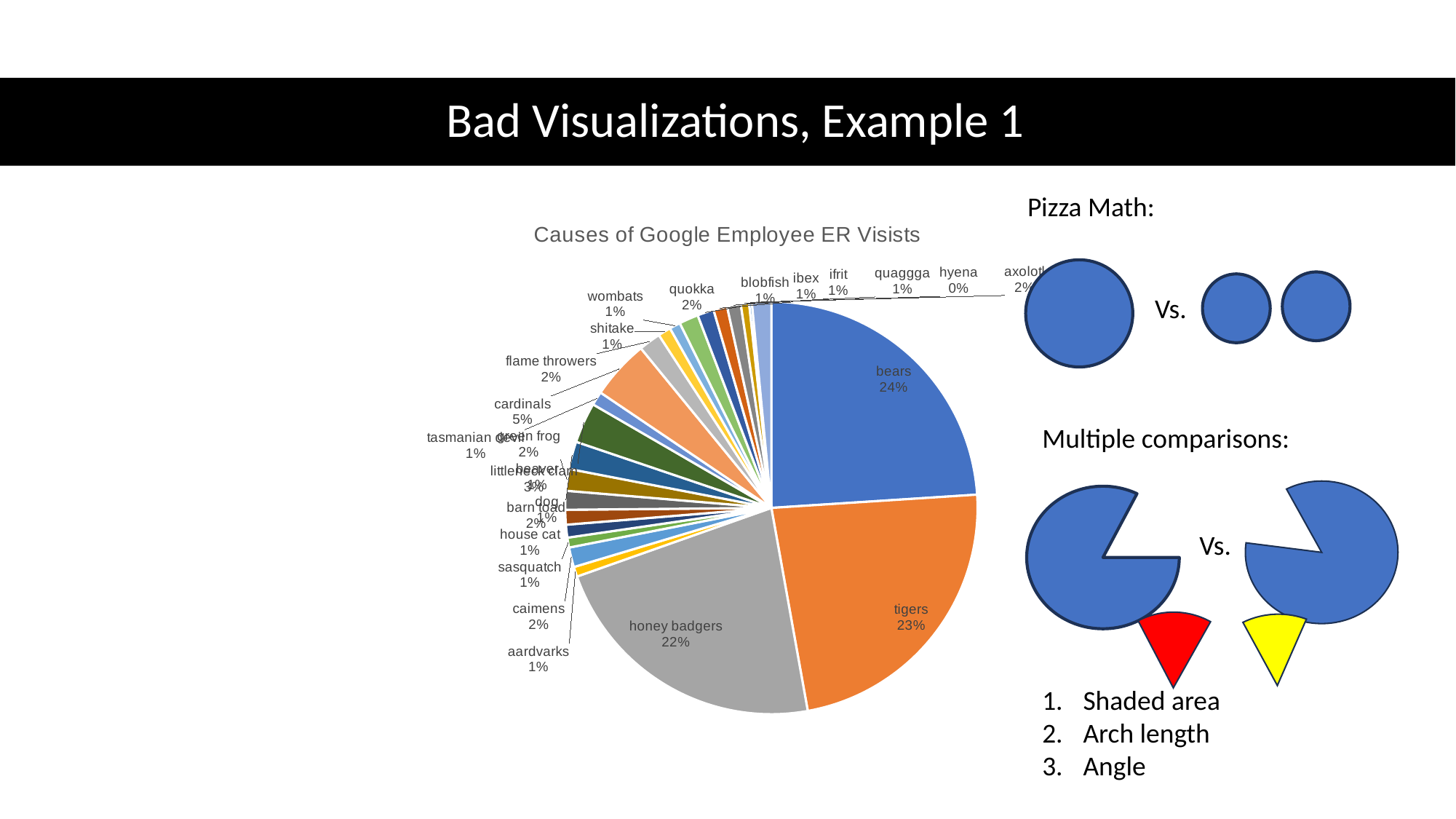
Which has a larger share, cardinals or quokka? cardinals What percentage of ER visits is attributed to honey badgers? 22% What percentage is shown for flame throwers? 2% What percentage of ER visits is attributed to bears? 24% What percentage of ER visits is attributed to cardinals? 5% Which cause has the largest share of the pie? bears What is the difference in percentage points between bears and honey badgers? 2 What is the title of the pie chart? Causes of Google Employee ER Visists What kind of chart is shown under the title "Causes of Google Employee ER Visists"? pie chart What percentage of ER visits is attributed to tigers? 23% What percentage is shown for hyena? 0% What share of the pie do tigers account for? 23%